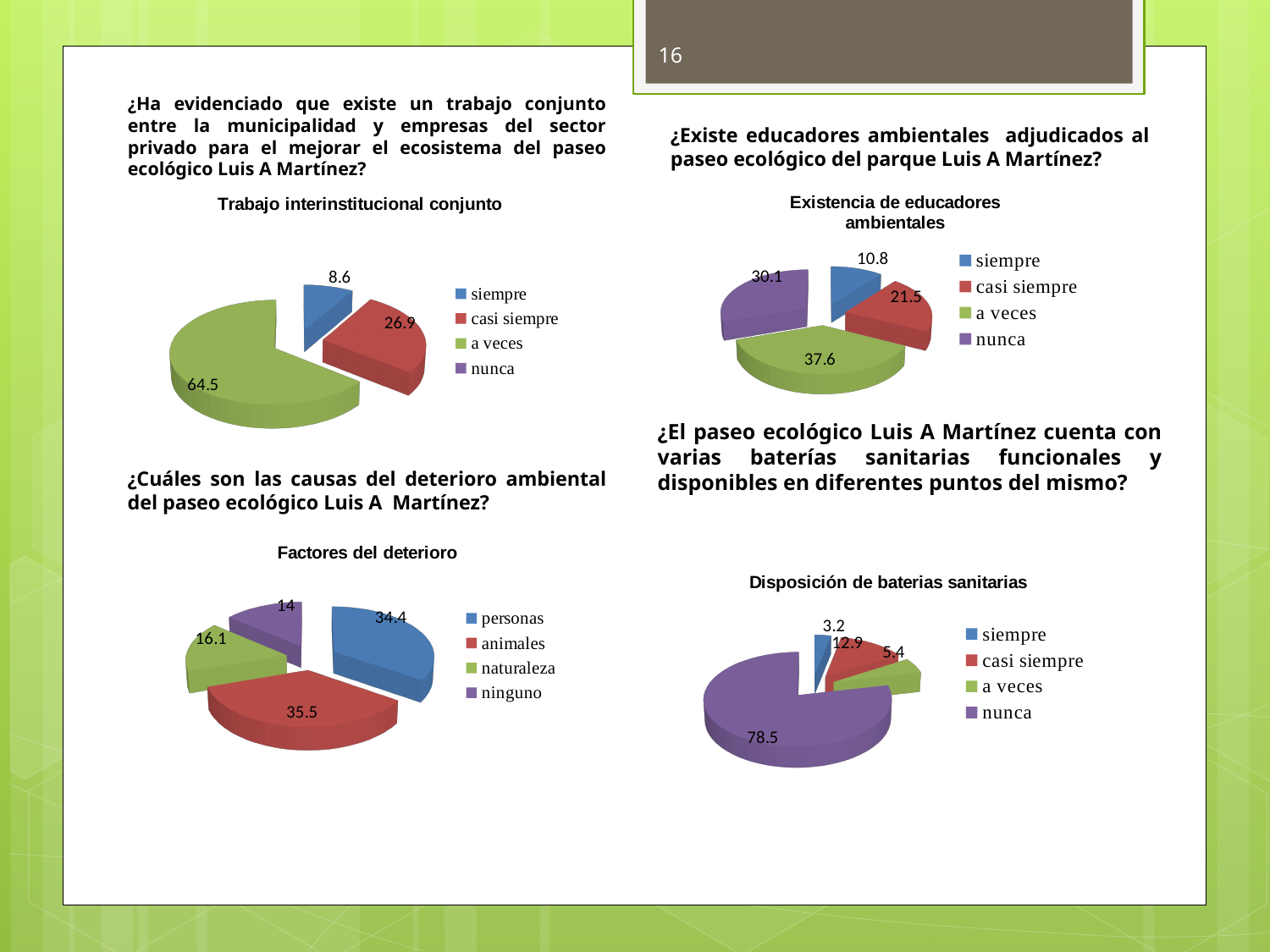
In the 'Existencia de educadores ambientales' chart, which category has the highest value? a veces In the 'Existencia de educadores ambientales' chart, what is the difference between 'a veces' and 'casi siempre'? 16.1 In the 'Disposición de baterias sanitarias' chart, what is the value for 'nunca'? 78.5 In the 'Factores del deterioro' chart, which category has the lowest value? ninguno In the 'Trabajo interinstitucional conjunto' chart, what is the value for 'a veces'? 64.5 In the 'Factores del deterioro' chart, how many categories does the legend list? 4 In the 'Existencia de educadores ambientales' chart, what is the value for 'nunca'? 30.1 In the 'Trabajo interinstitucional conjunto' chart, what is the value for 'siempre'? 8.6 In the 'Disposición de baterias sanitarias' chart, which is larger, 'casi siempre' or 'a veces'? casi siempre What type of chart is 'Disposición de baterias sanitarias'? Pie chart In the 'Existencia de educadores ambientales' chart, what colour represents 'nunca'? Purple In the 'Factores del deterioro' chart, what is the value for 'naturaleza'? 16.1